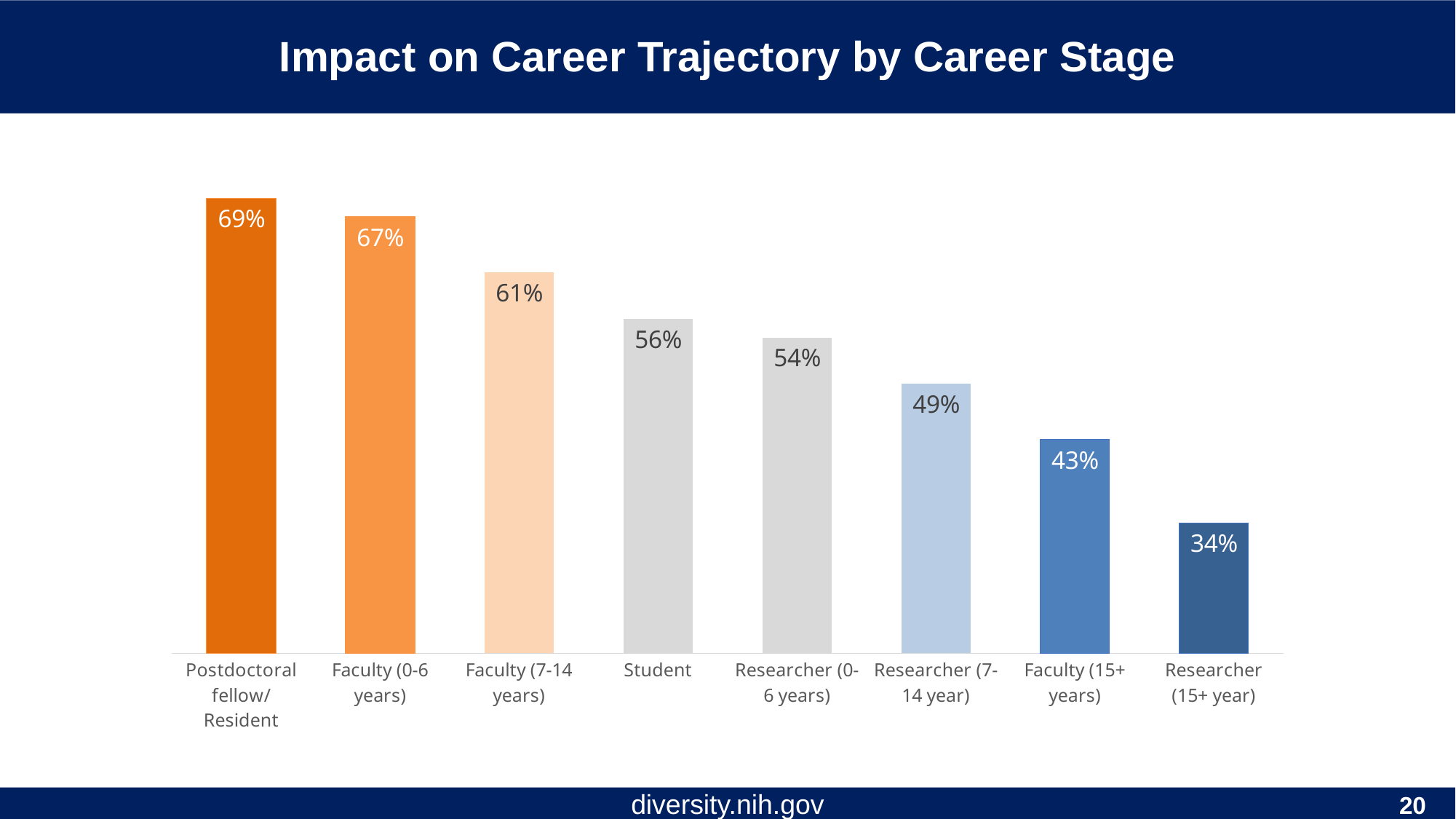
What is the difference between the values for Faculty (0-6 years) and Faculty (15+ years)? 24% What is the value for Researcher (15+ year)? 34% What is the value for Postdoctoral fellow/Resident? 69% Which career stage has the highest value? Postdoctoral fellow/Resident Do the values rise or fall from left to right across the categories? Fall What kind of chart is shown on the slide? Bar chart Which is larger, the value for Researcher (7-14 year) or the value for Faculty (15+ years)? Researcher (7-14 year) What is the value for Faculty (7-14 years)? 61% How many career stage categories are shown in the chart? 8 What is the value for Student? 56% What is the difference between the values for Student and Researcher (0-6 years)? 2% Which career stage has the lowest value? Researcher (15+ year)